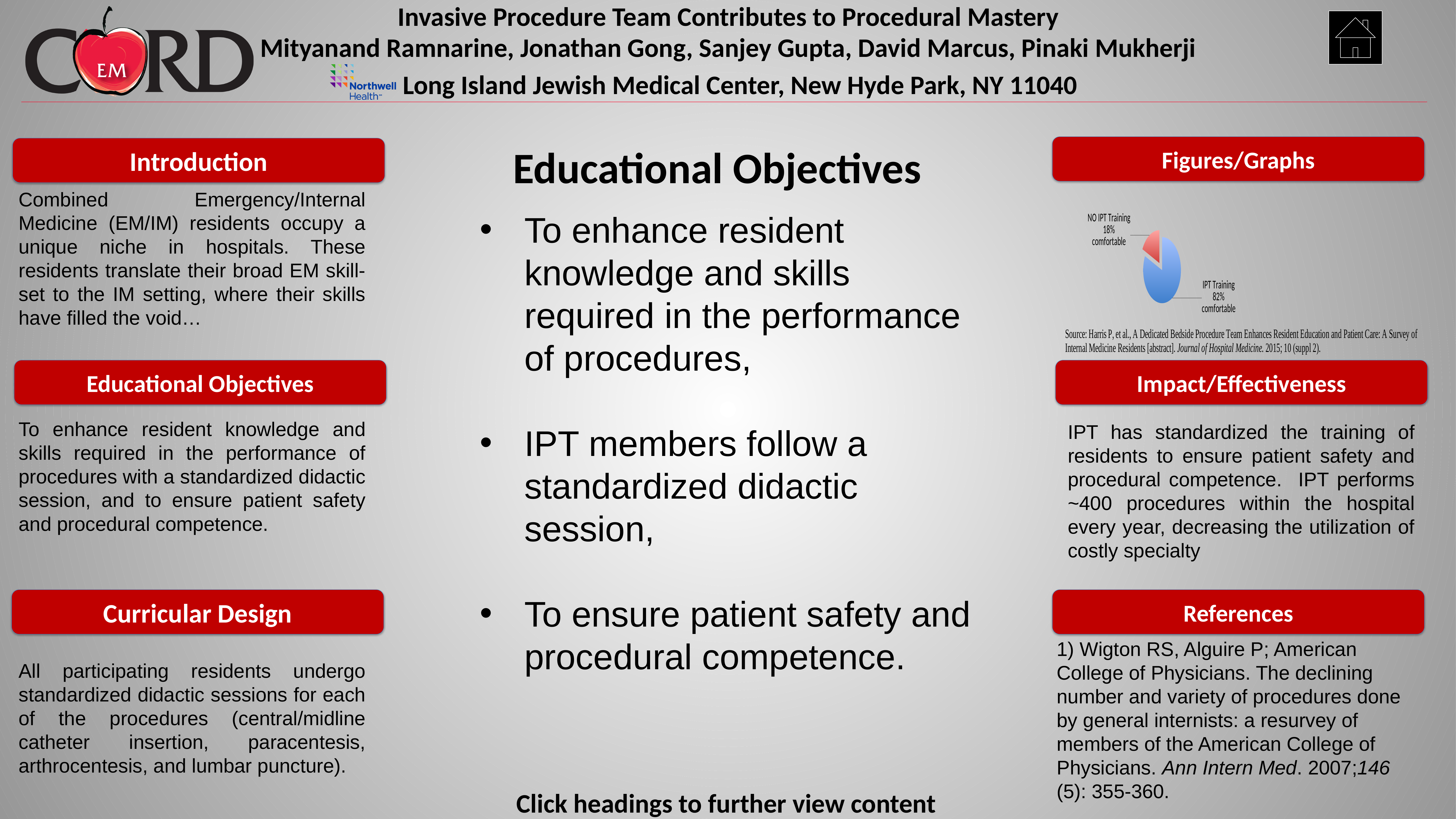
What colour is the IPT Training slice of the pie chart? blue Which is larger in the pie chart: IPT Training or NO IPT Training? IPT Training What percentage is shown for the NO IPT Training slice of the pie chart? 18% What kind of chart is shown in the Figures/Graphs section? pie chart Which slice of the pie chart is the largest? IPT Training What share of the pie does the NO IPT Training slice represent? 18% What share of the pie does the IPT Training slice represent? 82% How many slices does the pie chart have? 2 What percentage is shown for the IPT Training slice of the pie chart? 82% What colour is the NO IPT Training slice of the pie chart? red What is the difference in percentage points between the IPT Training and NO IPT Training slices? 64 Which slice of the pie chart is the smallest? NO IPT Training